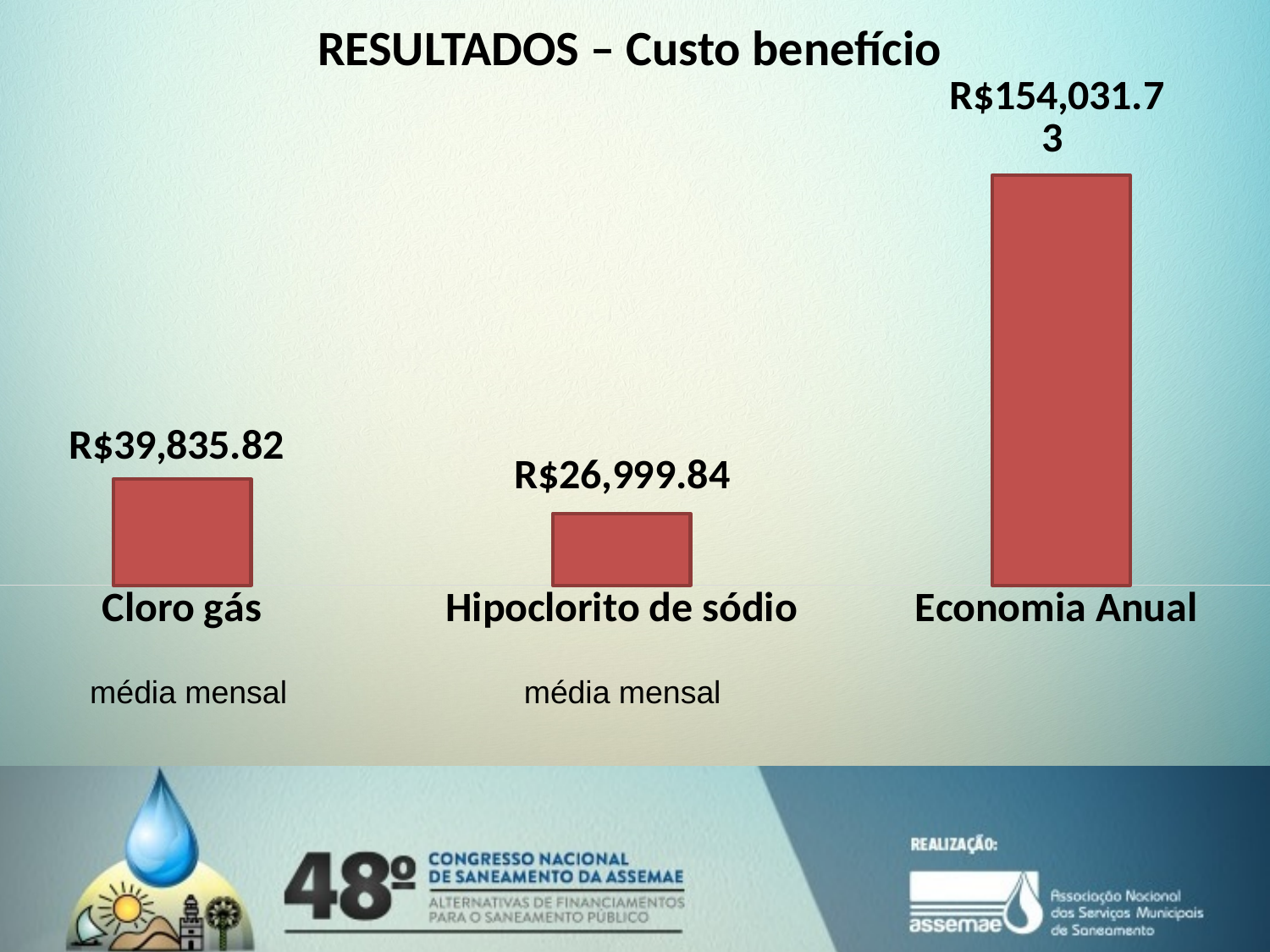
What is the difference between the values for Economia Anual and Cloro gás? R$114,195.91 What kind of chart is shown on the slide? Bar chart Which category has the lowest value? Hipoclorito de sódio What is the difference between the values for Cloro gás and Hipoclorito de sódio? R$12,835.98 What colour are the bars in the chart? Red Which category has the highest value? Economia Anual How many categories are shown in the chart? 3 What is the title of the slide? RESULTADOS – Custo benefício Which is larger, the value for Cloro gás or the value for Hipoclorito de sódio? Cloro gás What is the value for Hipoclorito de sódio? R$26,999.84 What is the value for Cloro gás? R$39,835.82 What is the value for Economia Anual? R$154,031.73